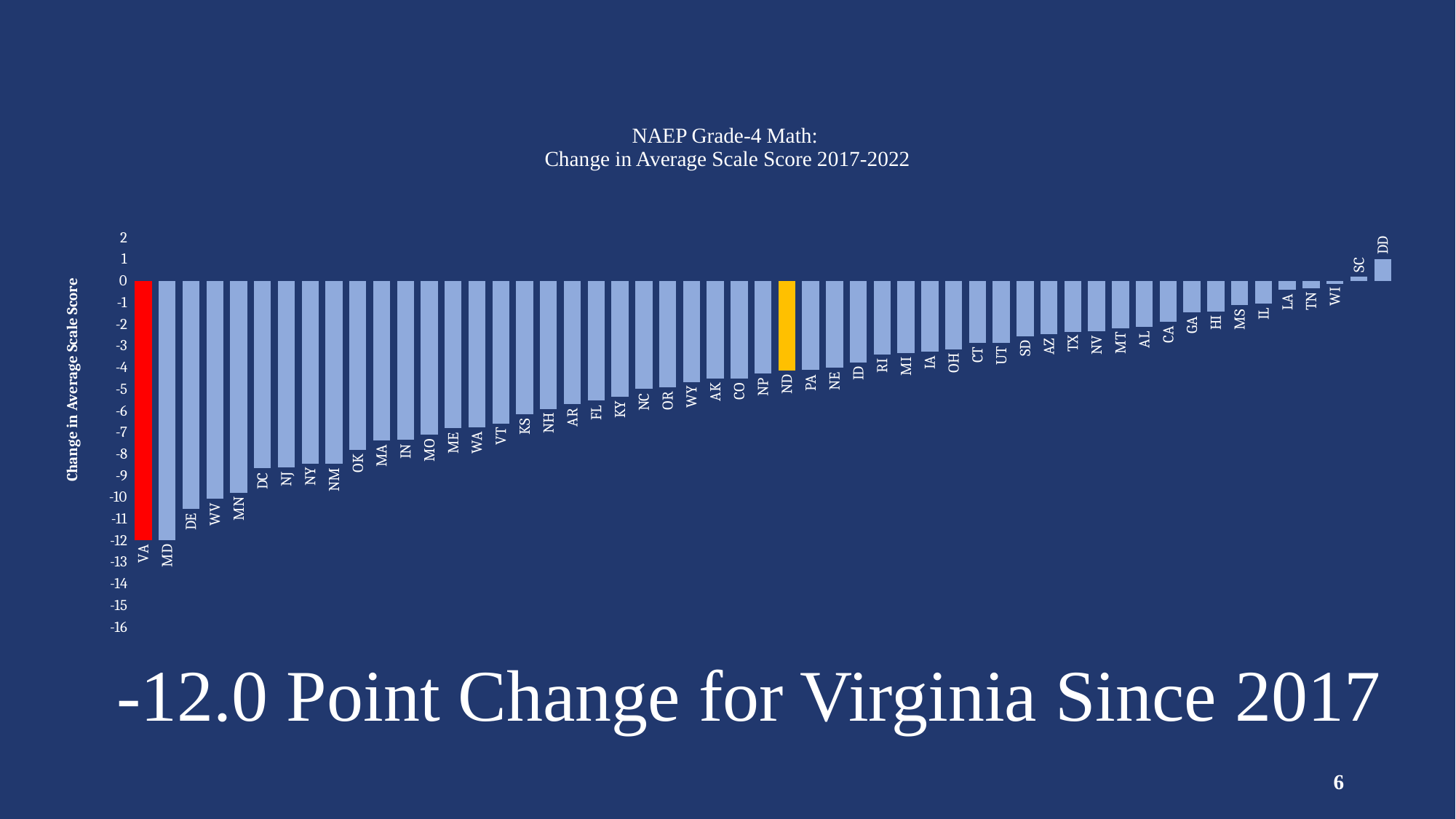
What is the change in average scale score for VA? -12.0 Which bar shows the highest change in average scale score? DD What is the title of the chart? NAEP Grade-4 Math: Change in Average Scale Score 2017-2022 Which state's bar is highlighted in red? VA Is the value for ND greater or less than -8? greater Is the value for DD greater or less than 0? greater What kind of chart is shown on the slide? bar chart Do the values rise or fall moving from left to right along the x axis? rise Is the value for NM greater or less than -5? less Which state has the lowest (most negative) change in average scale score? VA and MD (tied at -12)